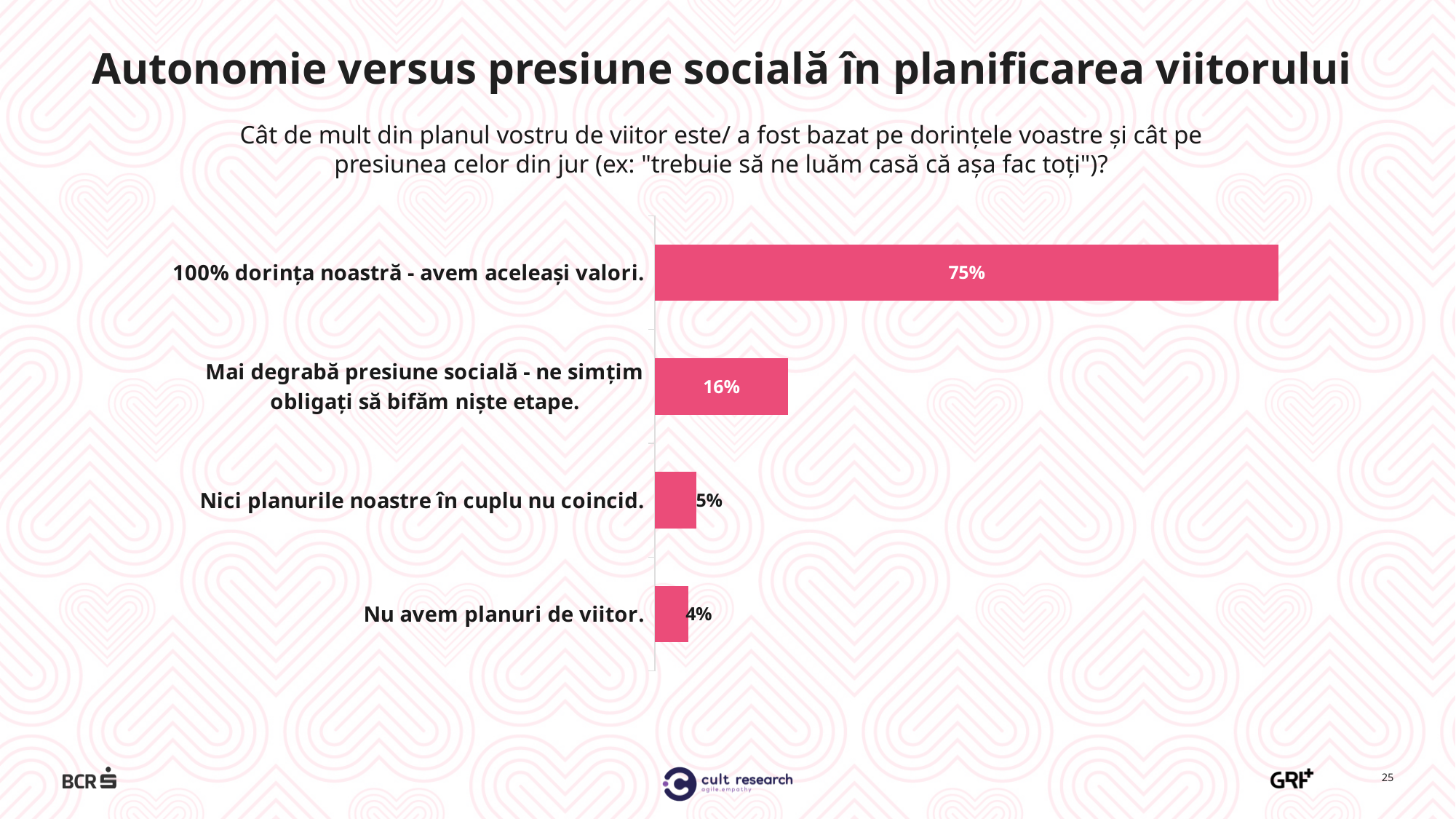
Which category has the lowest value? Nu avem planuri de viitor. What is the title of the slide? Autonomie versus presiune socială în planificarea viitorului What is the difference between the values for "100% dorința noastră - avem aceleași valori." and "Mai degrabă presiune socială - ne simțim obligați să bifăm niște etape."? 59% How many categories are shown in the chart? 4 What is the value for "Mai degrabă presiune socială - ne simțim obligați să bifăm niște etape."? 16% Which is larger: the value for "Mai degrabă presiune socială - ne simțim obligați să bifăm niște etape." or for "Nici planurile noastre în cuplu nu coincid."? Mai degrabă presiune socială - ne simțim obligați să bifăm niște etape. What percentage of respondents chose "100% dorința noastră - avem aceleași valori."? 75% What kind of chart is shown on the slide? Bar chart What is the value for "Nici planurile noastre în cuplu nu coincid."? 5% Which category has the highest value? 100% dorința noastră - avem aceleași valori. What is the difference between the values for "Mai degrabă presiune socială - ne simțim obligați să bifăm niște etape." and "Nici planurile noastre în cuplu nu coincid."? 11% What is the value for "Nu avem planuri de viitor."? 4%